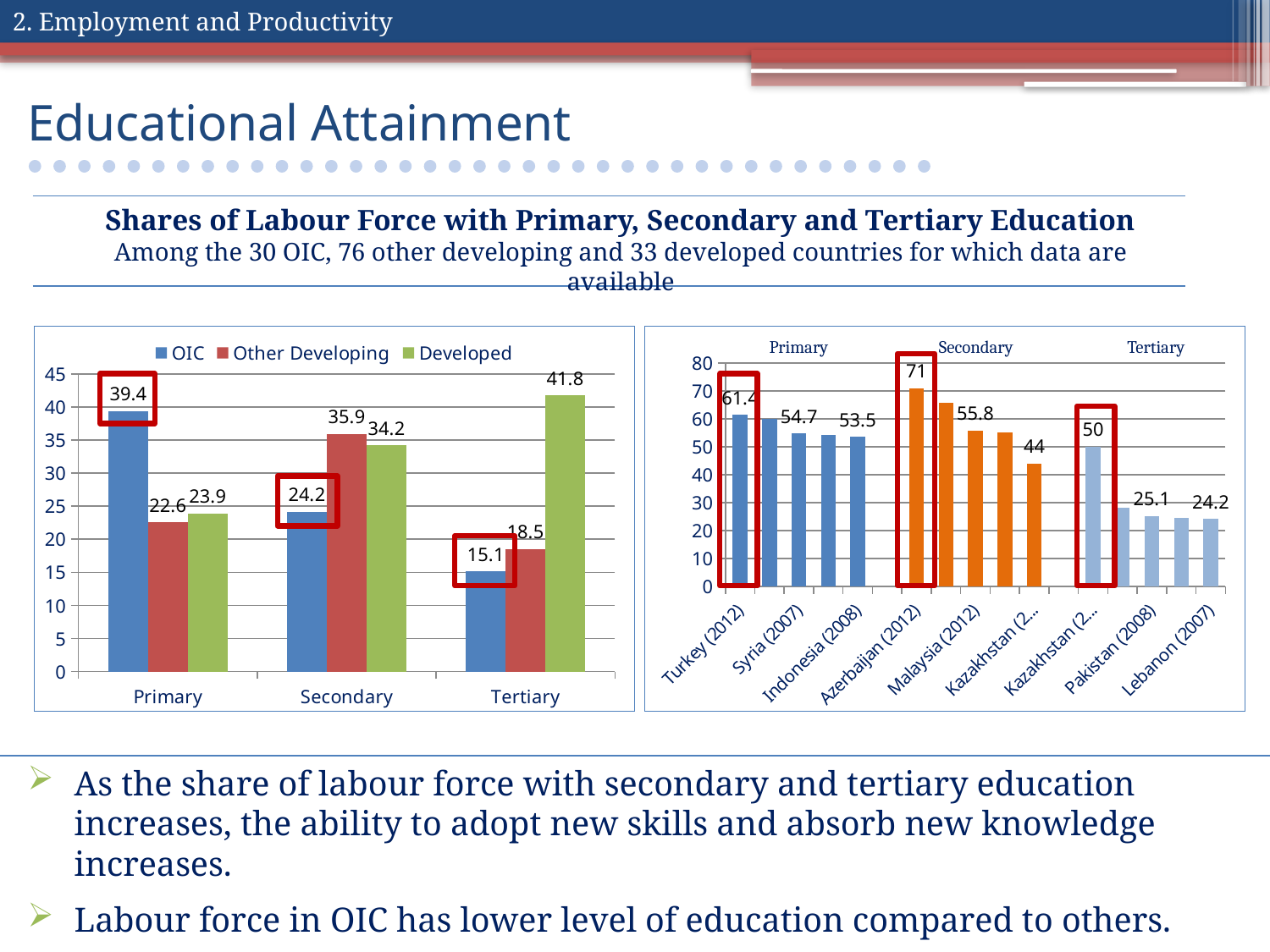
In the right chart, what is the value for Turkey (2012)? 61.4 In the left chart, which series has the highest value in the Primary category? OIC In the left chart, what is the value for Other Developing in the Secondary category? 35.9 In the right chart, what is the highest value shown? 71 In the left chart, what is the value for OIC in the Primary category? 39.4 In the left chart, what is the difference between the Developed and OIC values in the Tertiary category? 26.7 In the left chart, what is the value for Developed in the Tertiary category? 41.8 In the left chart, which is larger in the Secondary category: Other Developing or Developed? Other Developing What kind of chart is the left chart? Bar chart In the left chart, which series has the lowest value in the Tertiary category? OIC In the left chart, do the OIC values rise or fall from Primary to Tertiary? Fall How many series does the legend of the left chart list? 3